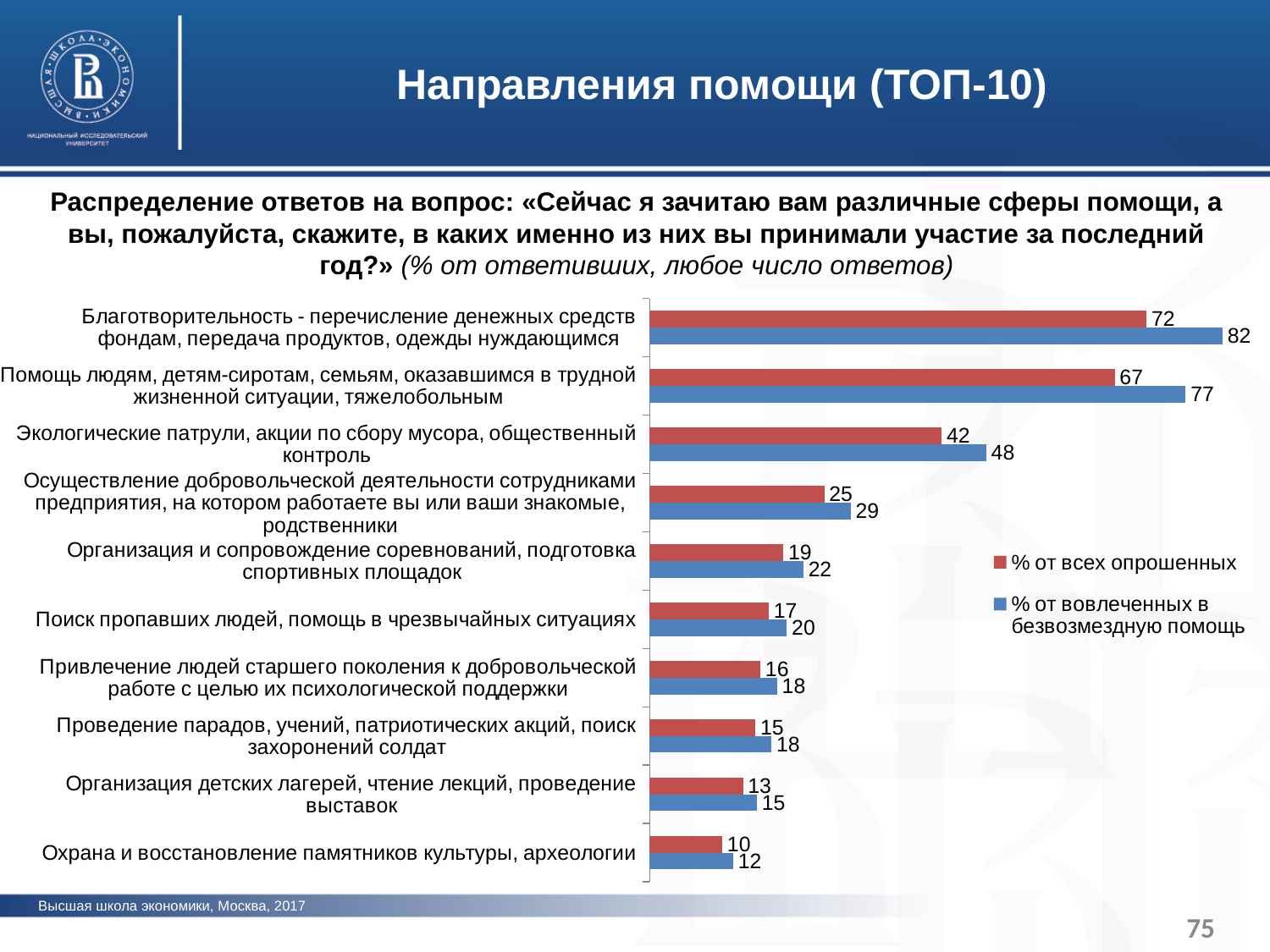
What is the value of "% от всех опрошенных" for "Поиск пропавших людей, помощь в чрезвычайных ситуациях"? 17 What is the value of "% от вовлеченных в безвозмездную помощь" for "Экологические патрули, акции по сбору мусора, общественный контроль"? 48 What is the value of "% от вовлеченных в безвозмездную помощь" for "Организация детских лагерей, чтение лекций, проведение выставок"? 15 What is the difference between the two series values for "Помощь людям, детям-сиротам, семьям, оказавшимся в трудной жизненной ситуации, тяжелобольным"? 10 Which colour represents the series "% от всех опрошенных" in the chart? Red Which category has the lowest value for "% от всех опрошенных"? Охрана и восстановление памятников культуры, археологии What type of chart is shown on the slide? Bar chart Which is larger: "% от всех опрошенных" for "Экологические патрули, акции по сбору мусора, общественный контроль" or for "Осуществление добровольческой деятельности сотрудниками предприятия, на котором работаете вы или ваши знакомые, родственники"? Экологические патрули, акции по сбору мусора, общественный контроль What is the value of "% от всех опрошенных" for "Благотворительность - перечисление денежных средств фондам, передача продуктов, одежды нуждающимся"? 72 How many categories (areas of help) are shown in the chart? 10 How many series does the legend list? 2 Which category has the highest value for "% от вовлеченных в безвозмездную помощь"? Благотворительность - перечисление денежных средств фондам, передача продуктов, одежды нуждающимся